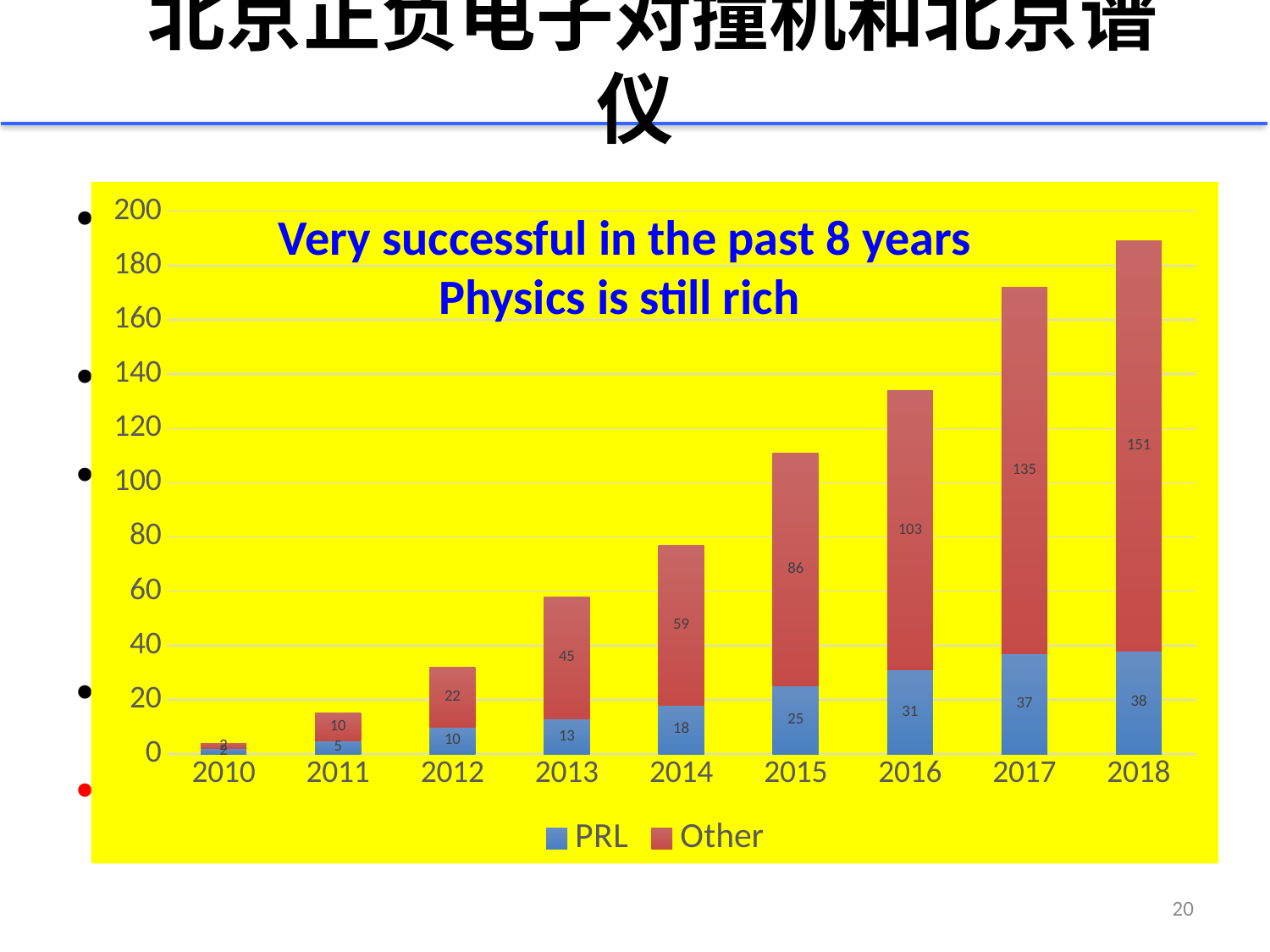
Which is larger, the PRL value for 2015 or the PRL value for 2013? 2015 What is the difference between the Other values for 2017 and 2016? 32 What type of chart is shown on the slide? stacked bar chart Which year has the highest Other value? 2018 What is the PRL value for 2014? 18 How many years are shown on the x axis? 9 Which series is shown in blue in the legend? PRL What is the PRL value for 2018? 38 Do the Other values rise or fall from 2011 to 2018? rise What is the Other value for 2016? 103 What is the total of the stacked bar for 2017? 172 How many series does the legend list? 2